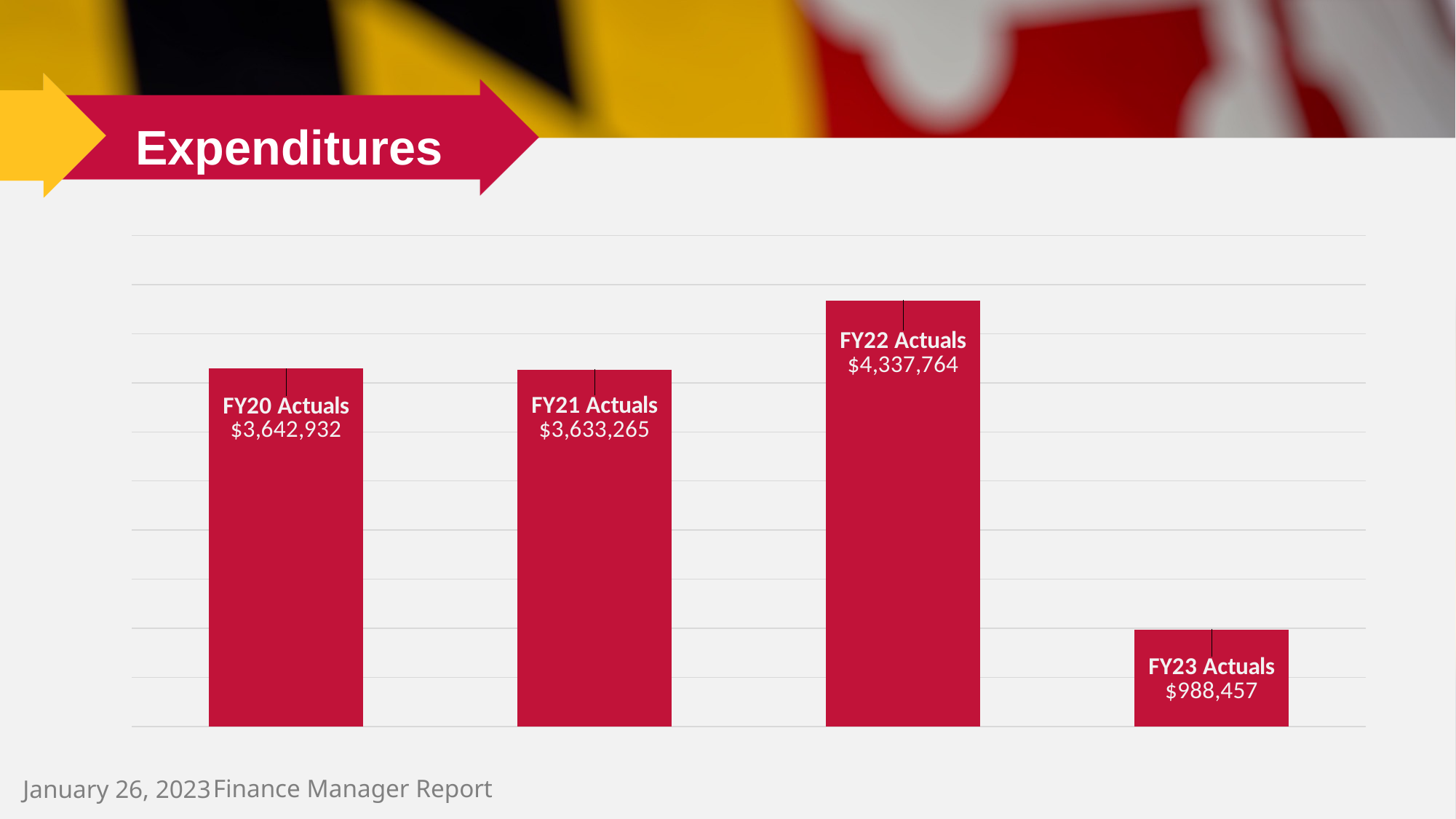
Which fiscal year has the lowest expenditures? FY23 Actuals What is the value for FY20 Actuals? $3,642,932 Which fiscal year has the highest expenditures? FY22 Actuals What is the difference between FY22 Actuals and FY20 Actuals? $694,832 What kind of chart is shown on the slide? Bar chart What is the value for FY23 Actuals? $988,457 What is the value for FY22 Actuals? $4,337,764 Do the values rise or fall from FY22 Actuals to FY23 Actuals? Fall What is the difference between FY22 Actuals and FY23 Actuals? $3,349,307 Which is larger, FY20 Actuals or FY21 Actuals? FY20 Actuals How many bars are shown in the chart? 4 What is the value for FY21 Actuals? $3,633,265